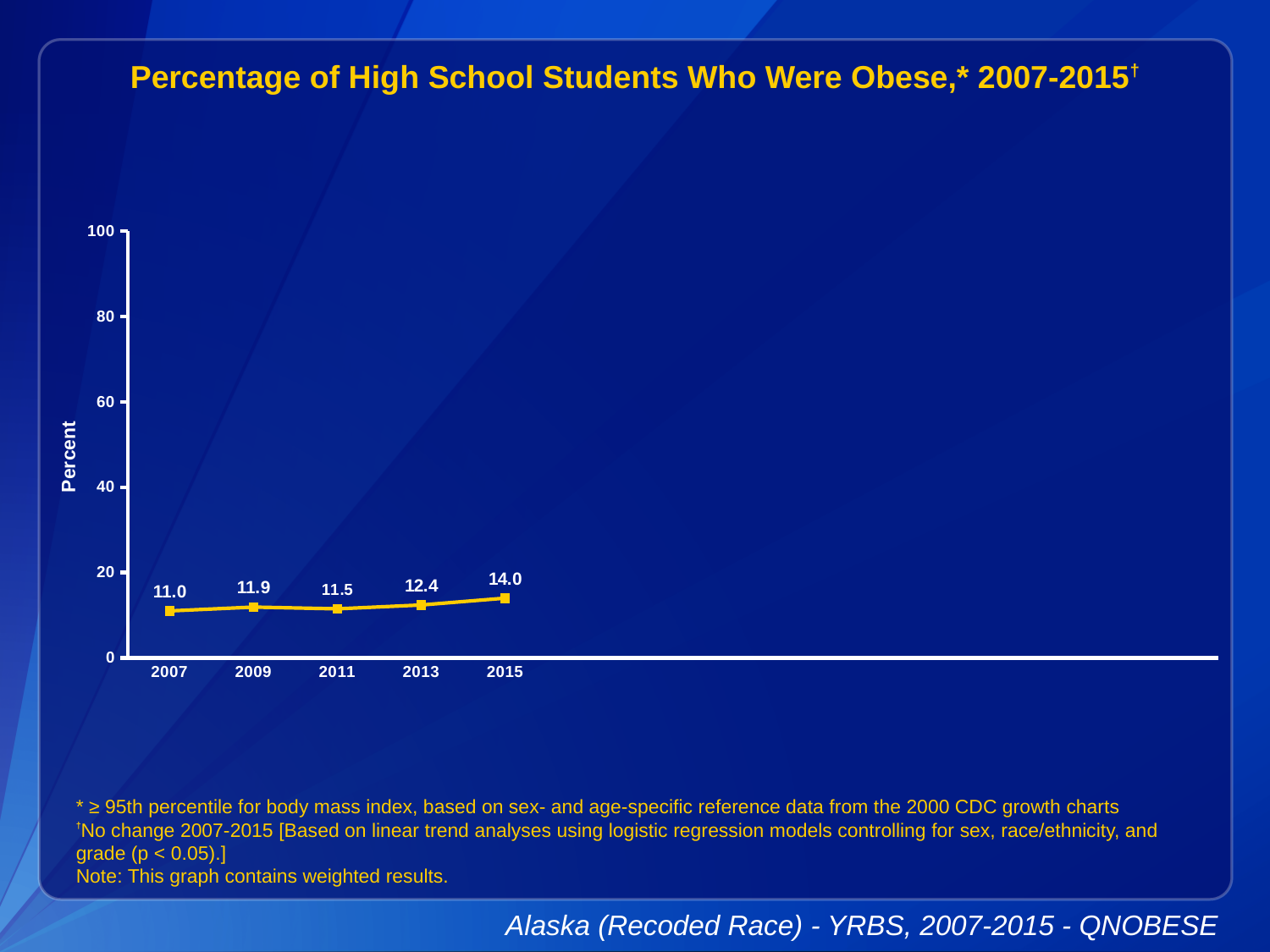
Which year has the lowest percentage of obese high school students? 2007 What kind of chart is shown on the slide? line chart What was the percentage of high school students who were obese in 2007? 11.0 What was the percentage of high school students who were obese in 2015? 14.0 How many years are plotted on the chart? 5 What value is shown for 2011? 11.5 What is the label on the y axis? Percent What is the difference between the 2015 value and the 2007 value? 3.0 What is the maximum value shown on the y axis? 100 Which year has a higher value, 2009 or 2011? 2009 Which year has the highest percentage of obese high school students? 2015 Is the value for 2013 greater or less than 20? less